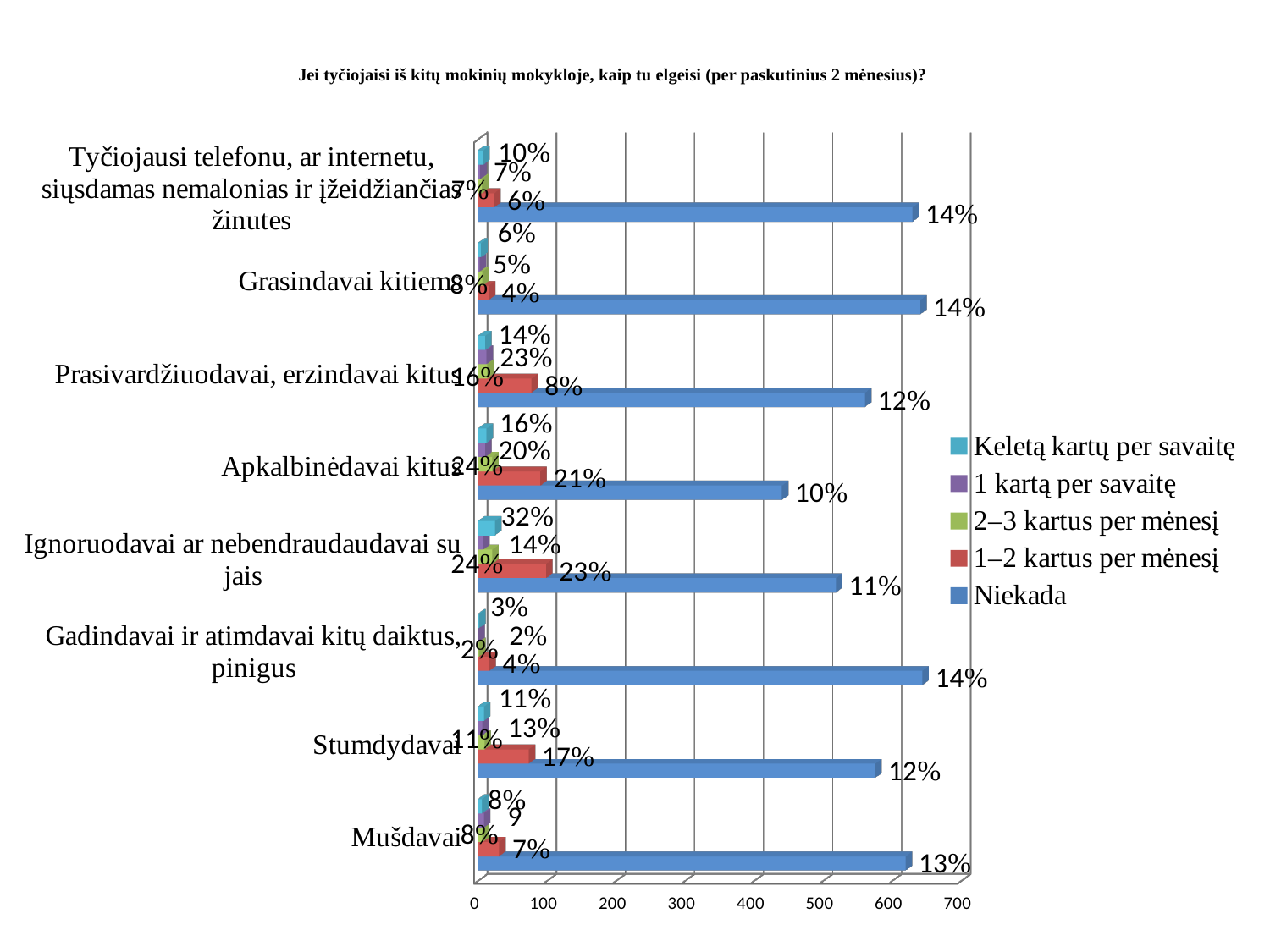
What is the data label for the 'Niekada' series on the 'Mušdavai' category? 13% Which category has the lowest 'Niekada' data label? Apkalbinėdavai kitus What is the difference between the '1–2 kartus per mėnesį' labels for 'Ignoruodavai ar nebendraudaudavai su jais' (23%) and 'Stumdydavai' (17%)? 6 percentage points What kind of chart is shown on the slide? Bar chart Which category has the highest '1–2 kartus per mėnesį' data label? Ignoruodavai ar nebendraudaudavai su jais What is the data label for the 'Keletą kartų per savaitę' series on the 'Ignoruodavai ar nebendraudaudavai su jais' category? 32% How many categories are shown on the chart? 8 Is the 'Niekada' bar for 'Apkalbinėdavai kitus' greater or less than 500 on the axis? less What is the data label for the 'Niekada' series on the 'Apkalbinėdavai kitus' category? 10% Which is larger: the '1–2 kartus per mėnesį' label for 'Apkalbinėdavai kitus' or for 'Stumdydavai'? Apkalbinėdavai kitus How many series does the legend list? 5 What is the data label for the '1–2 kartus per mėnesį' series on the 'Stumdydavai' category? 17%